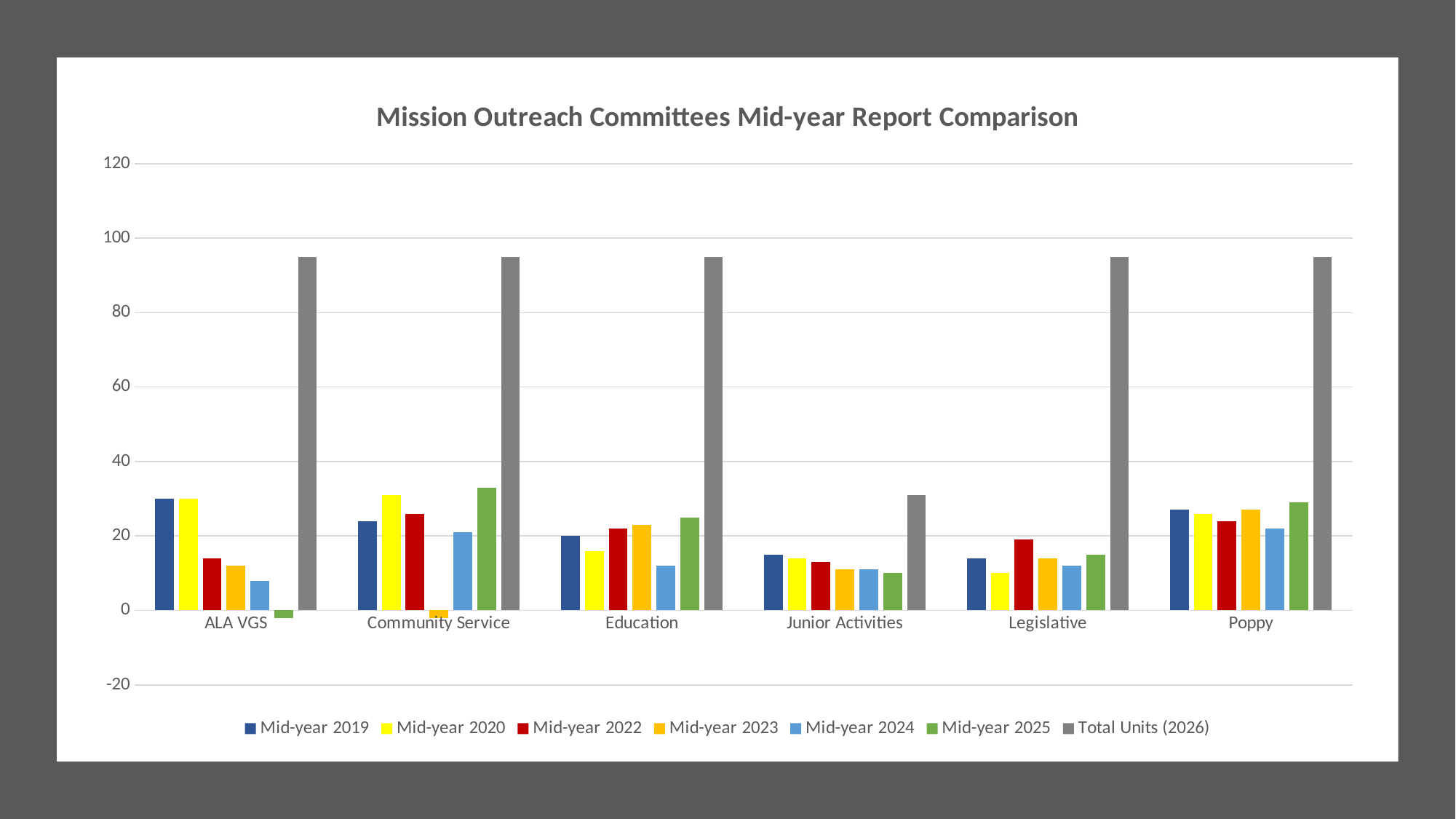
Is the Mid-year 2020 value for Community Service greater or less than 20? greater Which is larger, the Mid-year 2019 value for ALA VGS or for Junior Activities? ALA VGS Is the Total Units (2026) value for Junior Activities greater or less than 40? less What is the title of the chart? Mission Outreach Committees Mid-year Report Comparison How many committee categories are shown on the x axis? 6 What kind of chart is shown on the slide? bar chart Which category has the lowest Total Units (2026) value? Junior Activities Is the Mid-year 2020 value for Legislative greater or less than 20? less Which is larger, the Mid-year 2025 value for Community Service or for Education? Community Service How many series does the legend list? 7